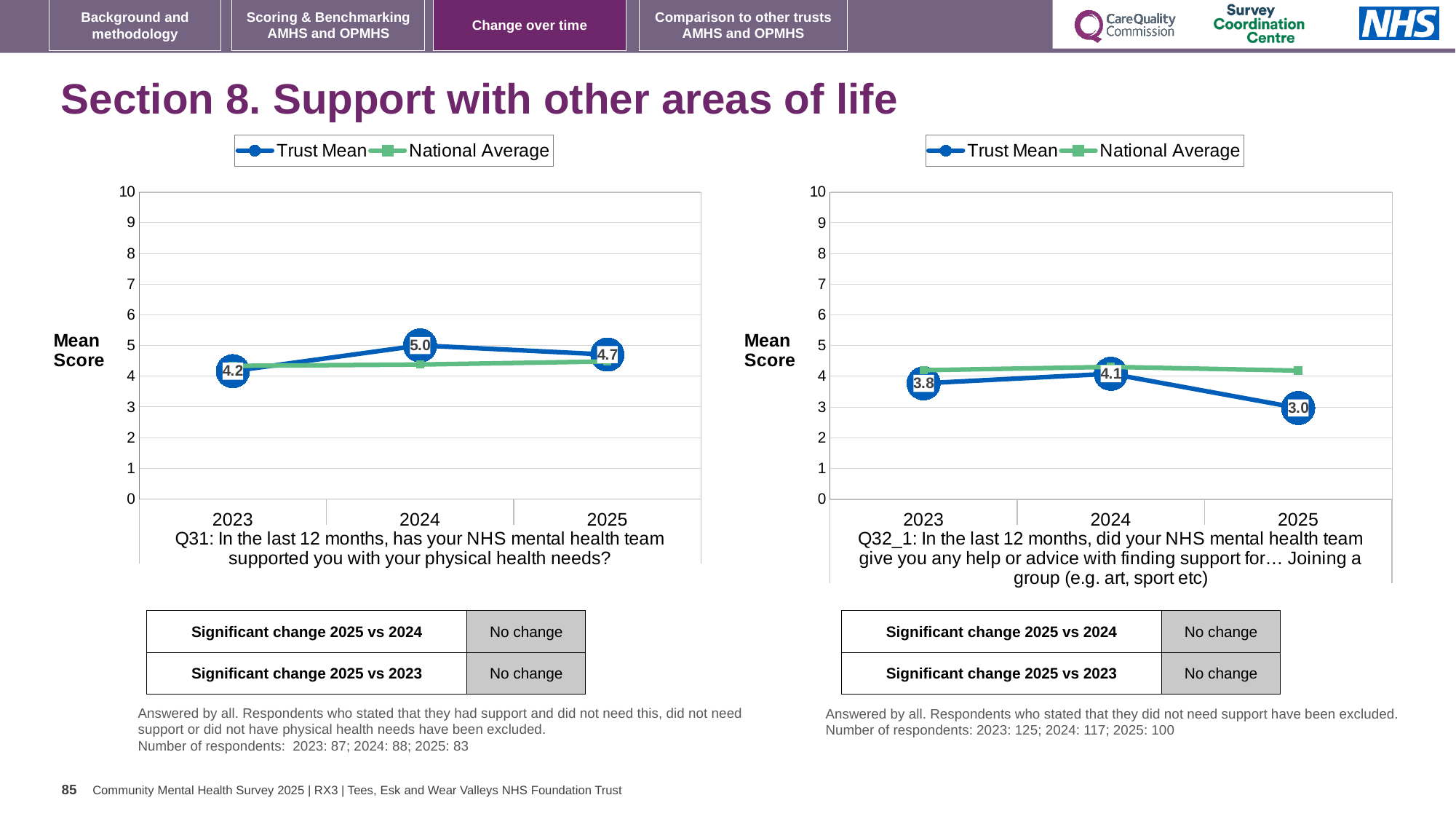
On the right chart (Q32_1), is the Trust Mean for 2025 greater or less than 4? less On the left chart (Q31), what is the Trust Mean for 2023? 4.2 On the left chart (Q31), what is the Trust Mean for 2024? 5.0 On the right chart (Q32_1), what is the Trust Mean for 2025? 3.0 On the right chart (Q32_1), does the Trust Mean rise or fall from 2024 to 2025? Fall On the left chart (Q31), how many series does the legend list? 2 On the left chart (Q31), what is the difference between the Trust Mean in 2024 and in 2023? 0.8 On the right chart (Q32_1), what is the Trust Mean for 2023? 3.8 On the right chart (Q32_1), what is the difference between the Trust Mean in 2024 and in 2025? 1.1 What kind of chart is the right chart (Q32_1)? Line chart On the right chart (Q32_1), which year has the lowest Trust Mean? 2025 On the left chart (Q31), which year has the highest Trust Mean? 2024